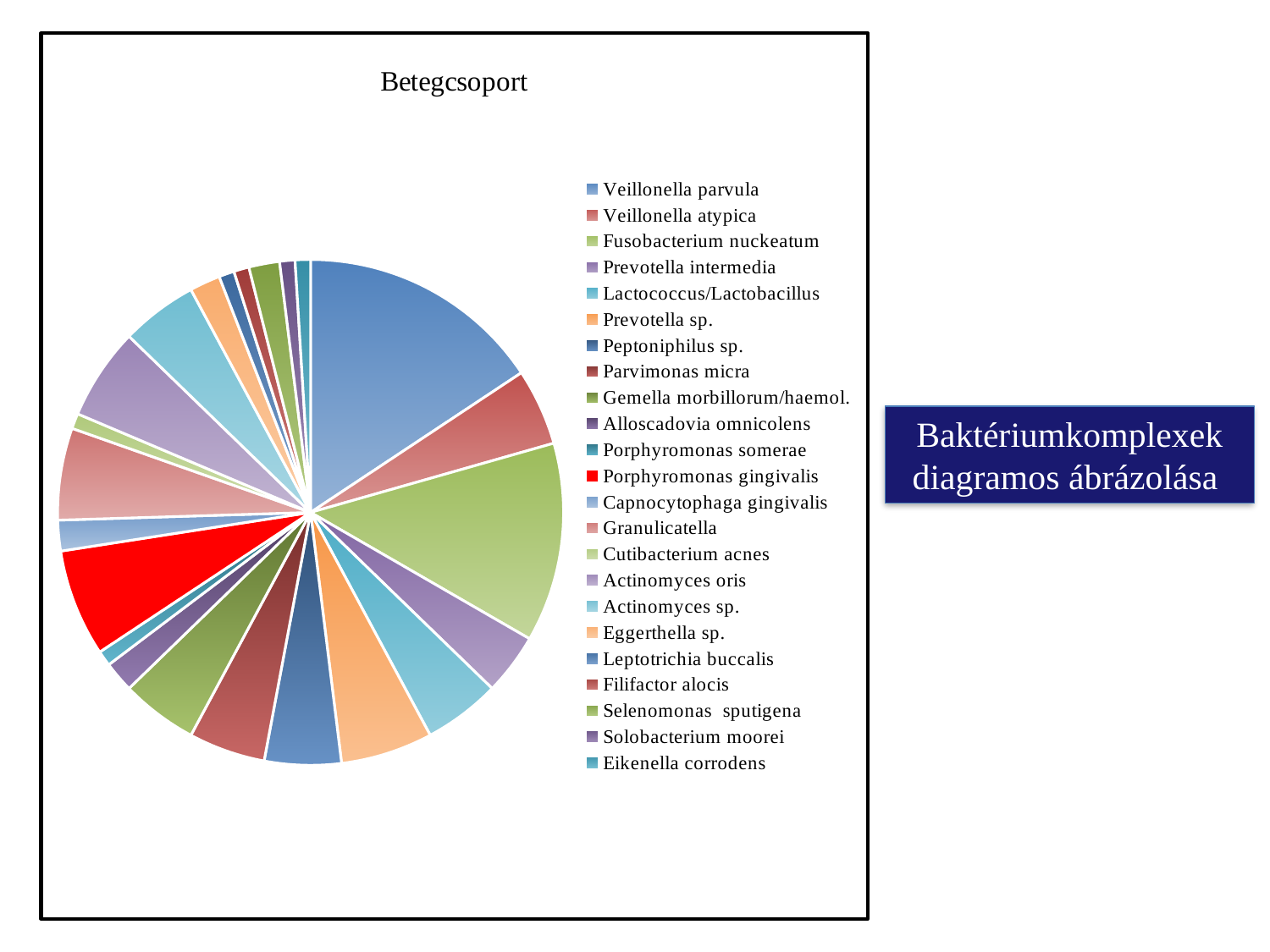
Which slice is larger, Veillonella parvula or Veillonella atypica? Veillonella parvula Which slice is larger, Fusobacterium nuckeatum or Prevotella intermedia? Fusobacterium nuckeatum How many entries does the legend list? 23 What colour is the slice for Porphyromonas gingivalis? red What kind of chart is shown on the slide? pie chart Which category has the largest slice of the pie? Veillonella parvula How many categories (slices) does the pie chart have? 23 Which slice is larger, Porphyromonas gingivalis or Porphyromonas somerae? Porphyromonas gingivalis What is the title of the chart? Betegcsoport